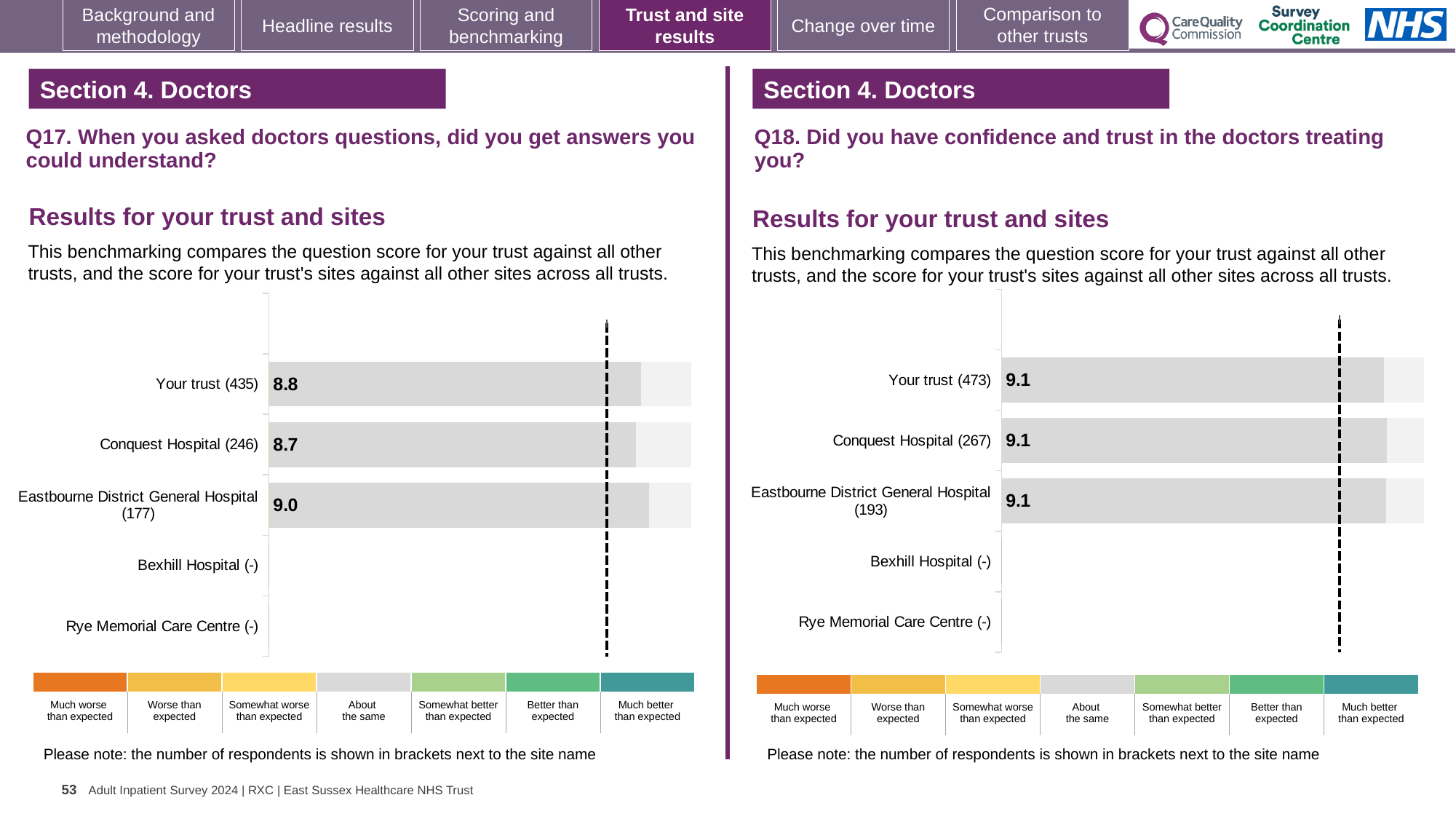
On the Q18 chart (right), what is the score for Eastbourne District General Hospital? 9.1 On the Q17 chart (left), what is the score for Conquest Hospital? 8.7 On the Q17 chart (left), what is the score for Eastbourne District General Hospital? 9.0 On the Q17 chart (left), which site has the highest score? Eastbourne District General Hospital What kind of chart is used on the Q18 chart (right)? Bar chart On the Q17 chart (left), which of the plotted bars has the lowest score? Conquest Hospital How many site/trust categories are listed on the Q17 chart (left)? 5 On the Q17 chart (left), what is the score for Your trust? 8.8 On the Q17 chart (left), what is the difference between the scores for Eastbourne District General Hospital and Conquest Hospital? 0.3 On the Q18 chart (right), how many respondents are shown for Conquest Hospital? 267 On the Q17 chart (left), which has the larger score, Your trust or Conquest Hospital? Your trust On the Q18 chart (right), what is the score for Your trust? 9.1